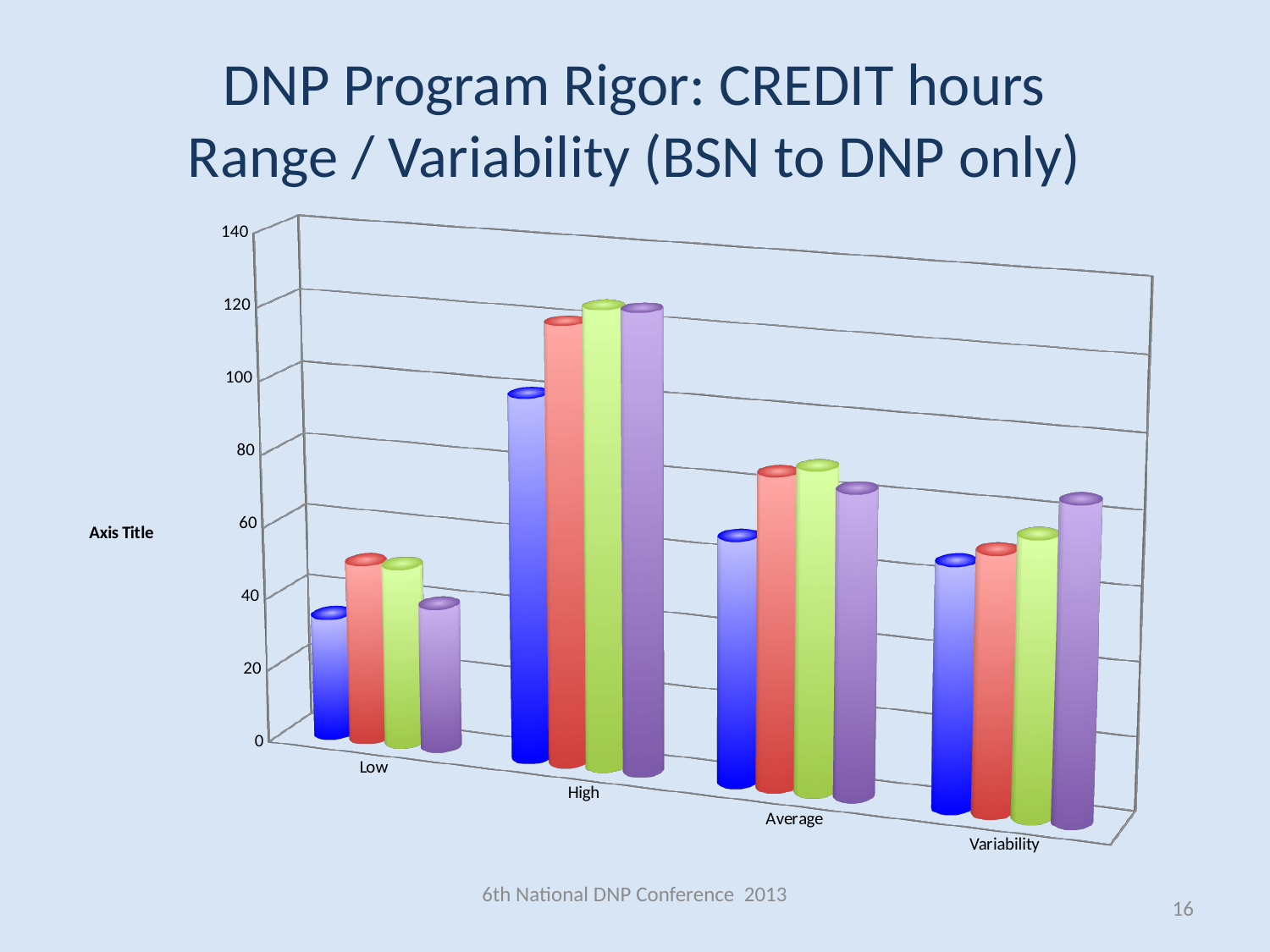
Which is larger, the blue bar for High or the blue bar for Low? High Which category has the tallest bars in the chart? High Is the value of the red bar for High greater or less than 100? greater How many bars are plotted for each category in the chart? 4 Is the value of the blue bar for High greater or less than 80? greater Is the value of the purple bar for Average greater or less than 100? less Which category has the shortest bars in the chart? Low How many categories are shown on the x axis of the chart? 4 What kind of chart is shown on the slide? bar chart What is the highest value shown on the vertical axis of the chart? 140 Which is larger, the green bar for Average or the green bar for Variability? Average